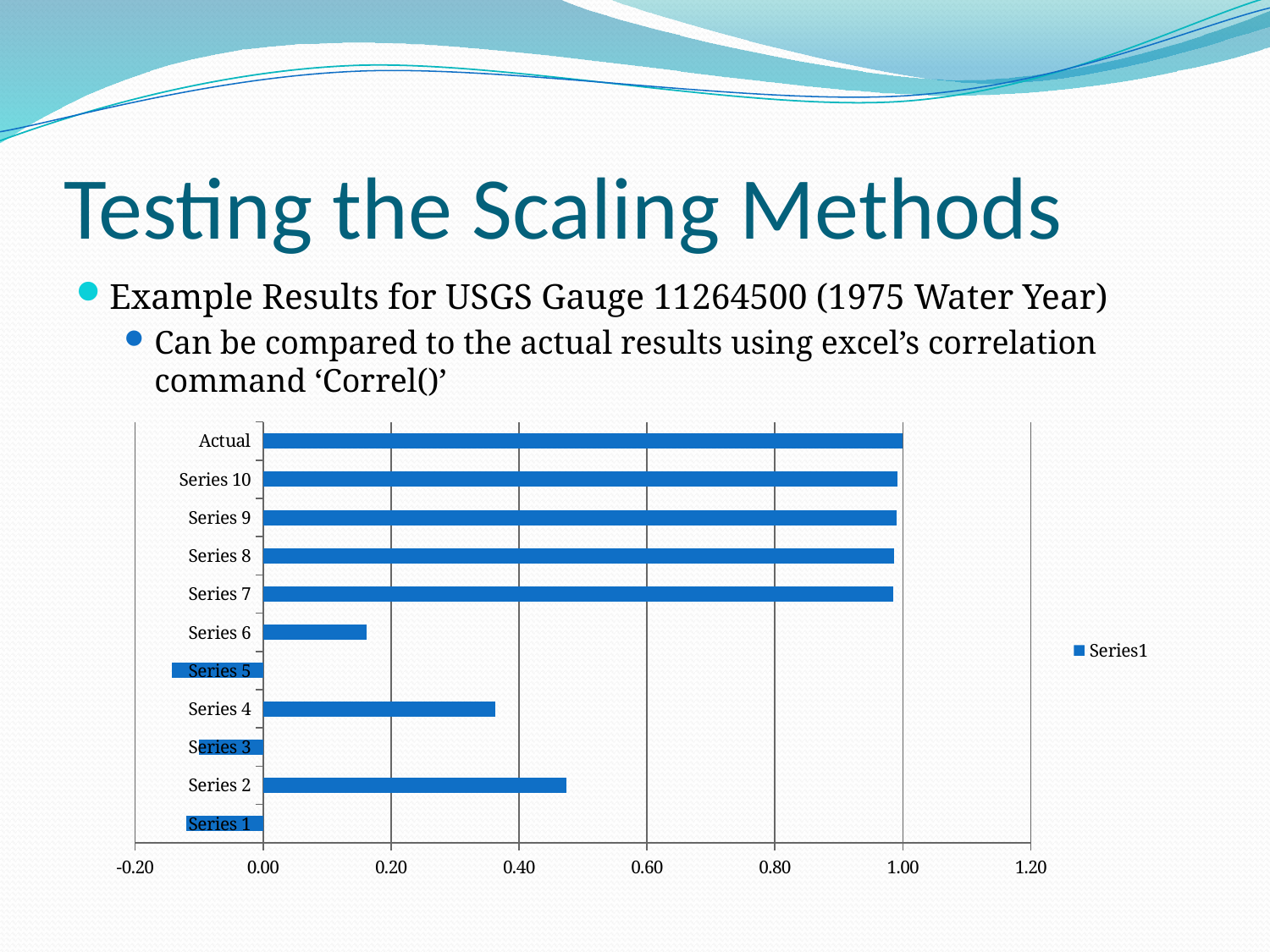
Which category has the lowest value on the chart? Series 5 Is the value for Series 4 greater or less than 0.40? less Which has the larger value, Series 2 or Series 4? Series 2 What is the name of the series shown in the chart's legend? Series1 How many series does the chart's legend list? 1 How many categories on the chart have a negative value? 3 Is the value for Series 7 greater or less than 0.80? greater Is the value for Series 6 greater or less than 0.20? less What kind of chart is shown on the slide? Bar chart How many categories are plotted on the chart's vertical axis? 11